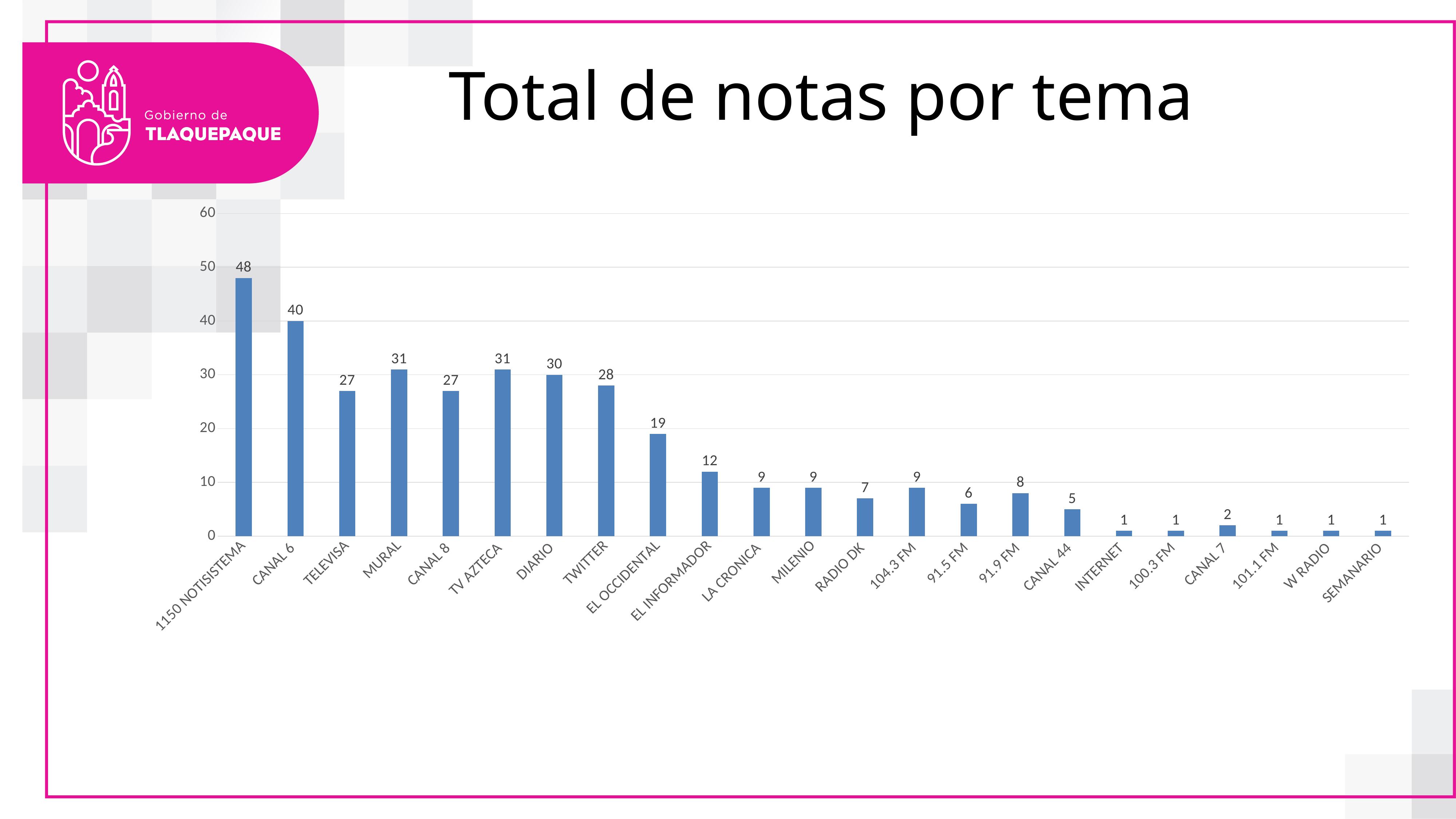
What is the value for RADIO DK? 7 How many categories are shown on the x axis? 23 What is the difference between the values for 1150 NOTISISTEMA and CANAL 6? 8 Which category has the highest value? 1150 NOTISISTEMA What is the value for CANAL 7? 2 What is the value for CANAL 6? 40 What kind of chart is shown on the slide? bar chart Is the value for MURAL greater or less than 30? greater What is the value for EL OCCIDENTAL? 19 Which is larger, the value for DIARIO or the value for TWITTER? DIARIO What is the title of the slide? Total de notas por tema What is the difference between the values for EL OCCIDENTAL and EL INFORMADOR? 7